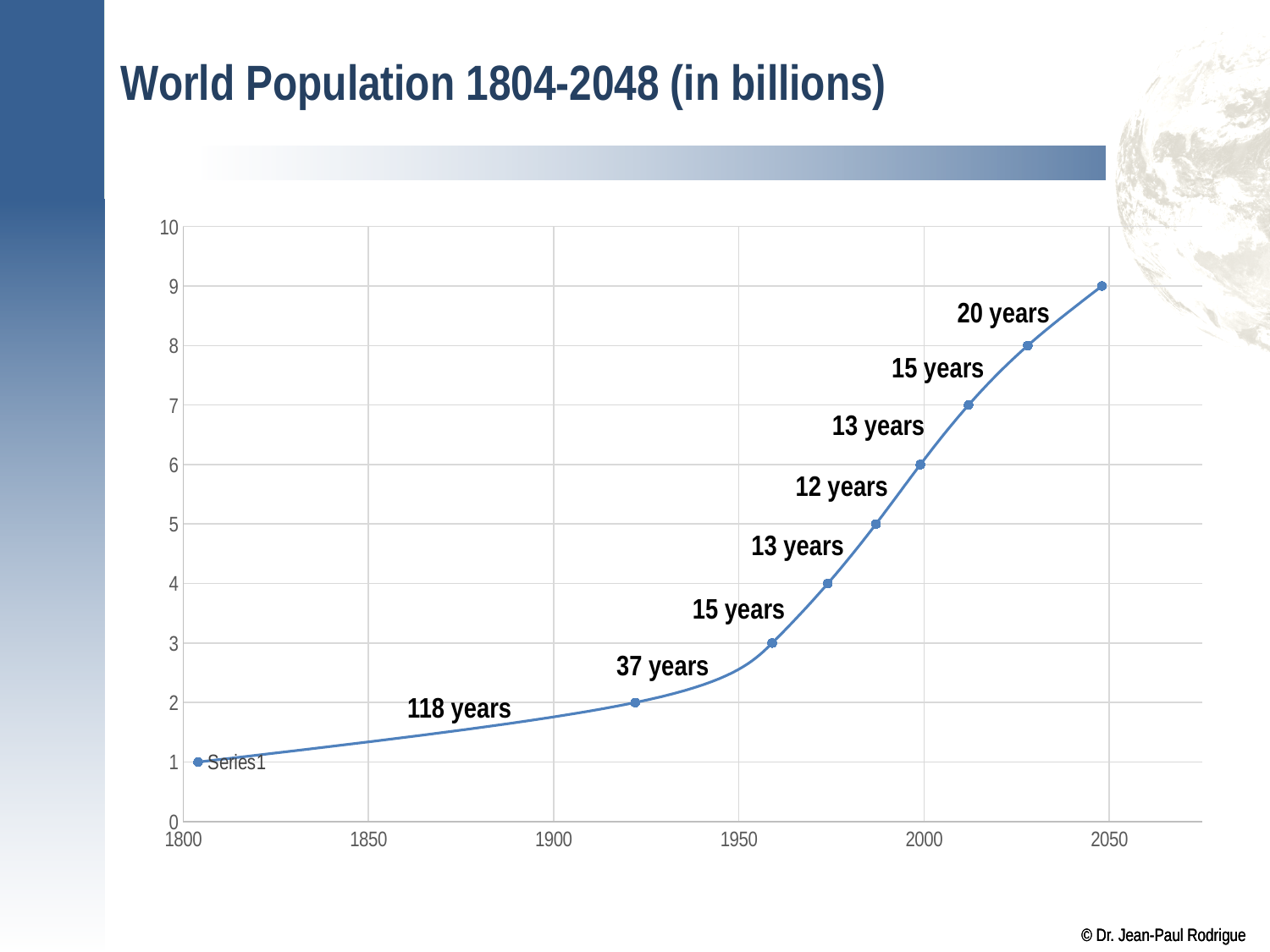
What is the highest population value plotted on the chart, in billions? 9 What is the title of the chart on the slide? World Population 1804-2048 (in billions) What is the shortest interval labelled on the chart between consecutive billion milestones? 12 years What kind of chart is shown on the slide? line chart What is the lowest population value plotted on the chart, in billions? 1 According to the label on the chart, how many years did it take for the world population to grow from 8 billion to 9 billion? 20 years Is the plotted population value at the year 1950 greater or less than 3 billion? less Do the plotted values rise or fall as the years increase along the x axis? rise What is the difference, in billions, between the highest and lowest plotted population values? 8 According to the label on the chart, how many years did it take for the world population to grow from 1 billion to 2 billion? 118 years Which took longer according to the chart labels: growing from 1 to 2 billion or from 2 to 3 billion? 1 to 2 billion How many data points are plotted on the line? 9